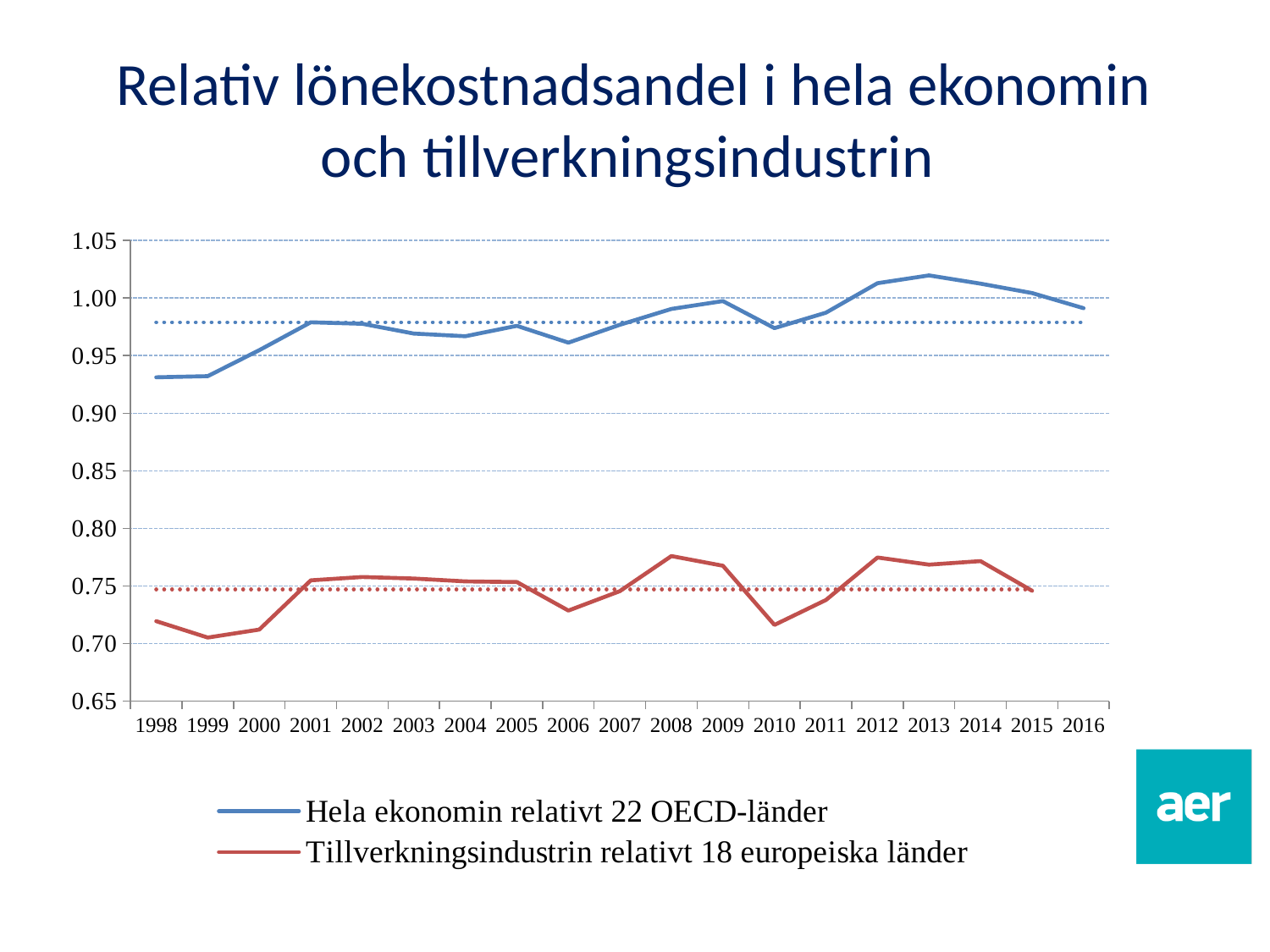
In which year does the Hela ekonomin relativt 22 OECD-länder series reach its highest value? 2013 Is the value for Hela ekonomin relativt 22 OECD-länder in 2013 greater or less than 1.00? greater Is the value for Hela ekonomin relativt 22 OECD-länder in 1998 greater or less than 0.95? less Does the Tillverkningsindustrin relativt 18 europeiska länder series rise or fall from 2008 to 2010? Fall Is the value for Tillverkningsindustrin relativt 18 europeiska länder in 1999 greater or less than 0.75? less What is the title of the chart? Relativ lönekostnadsandel i hela ekonomin och tillverkningsindustrin Which series is drawn with the blue line? Hela ekonomin relativt 22 OECD-länder How many years are shown on the x axis? 19 How many series does the legend list? 2 What kind of chart is shown on the slide? Line chart